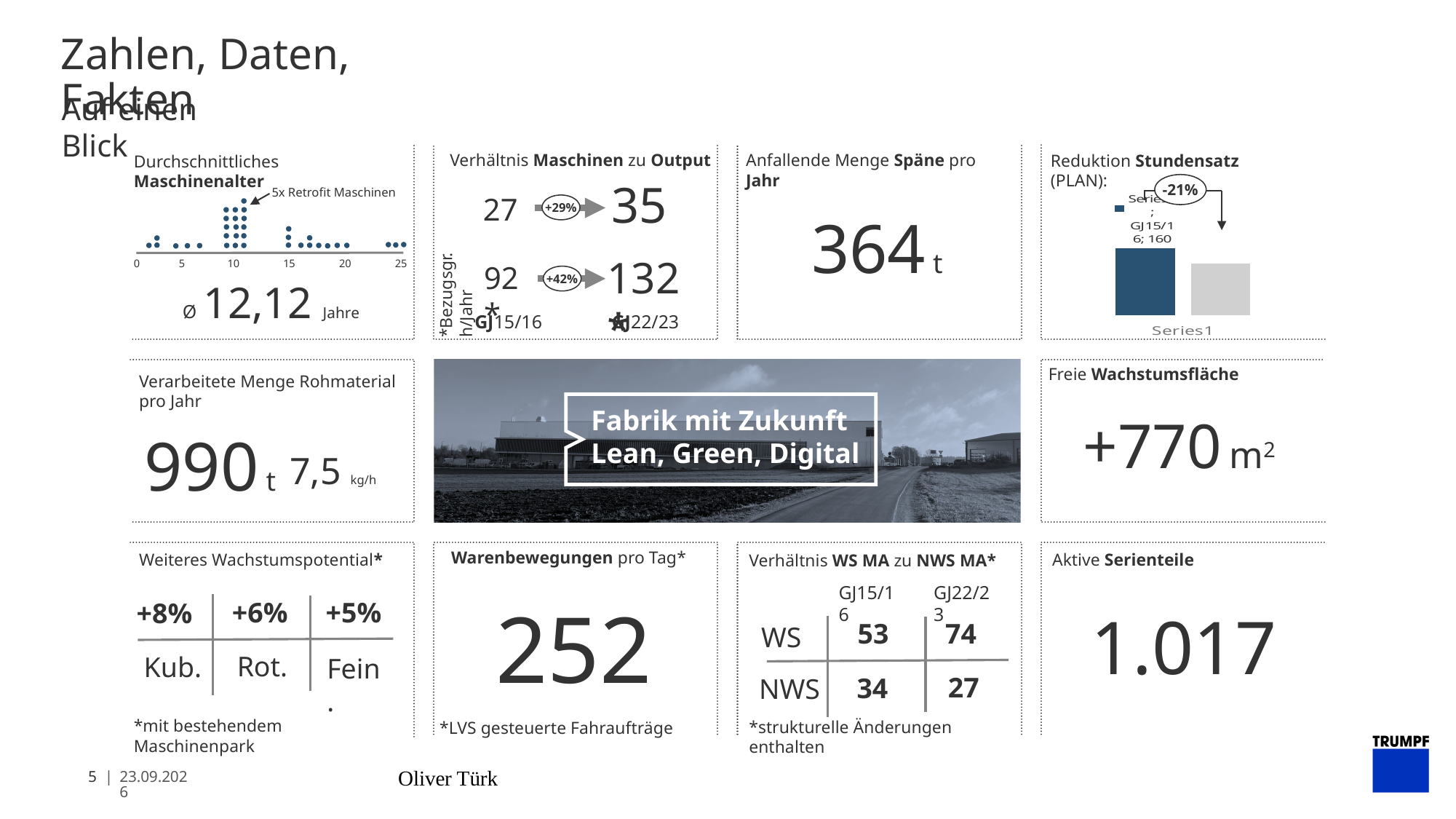
How many bars does the 'Reduktion Stundensatz (PLAN)' chart show? 2 What label appears below the bars on the horizontal axis of the 'Reduktion Stundensatz (PLAN)' chart? Series1 What average machine age is printed below the 'Durchschnittliches Maschinenalter' chart? 12,12 Jahre What kind of chart is shown in the 'Reduktion Stundensatz (PLAN)' panel? bar chart How many tick labels are shown on the x axis of the 'Durchschnittliches Maschinenalter' chart? 6 In the 'Reduktion Stundensatz (PLAN)' chart, what value is labelled for GJ15/16? 160 What is the highest tick value on the x axis of the 'Durchschnittliches Maschinenalter' chart? 25 In the 'Reduktion Stundensatz (PLAN)' chart, which bar is taller, the left dark blue one or the right grey one? the left dark blue one What percentage change is annotated above the bars in the 'Reduktion Stundensatz (PLAN)' chart? -21% In the 'Reduktion Stundensatz (PLAN)' chart, is the right grey bar greater or less than 160? less What is the lowest tick value on the x axis of the 'Durchschnittliches Maschinenalter' chart? 0